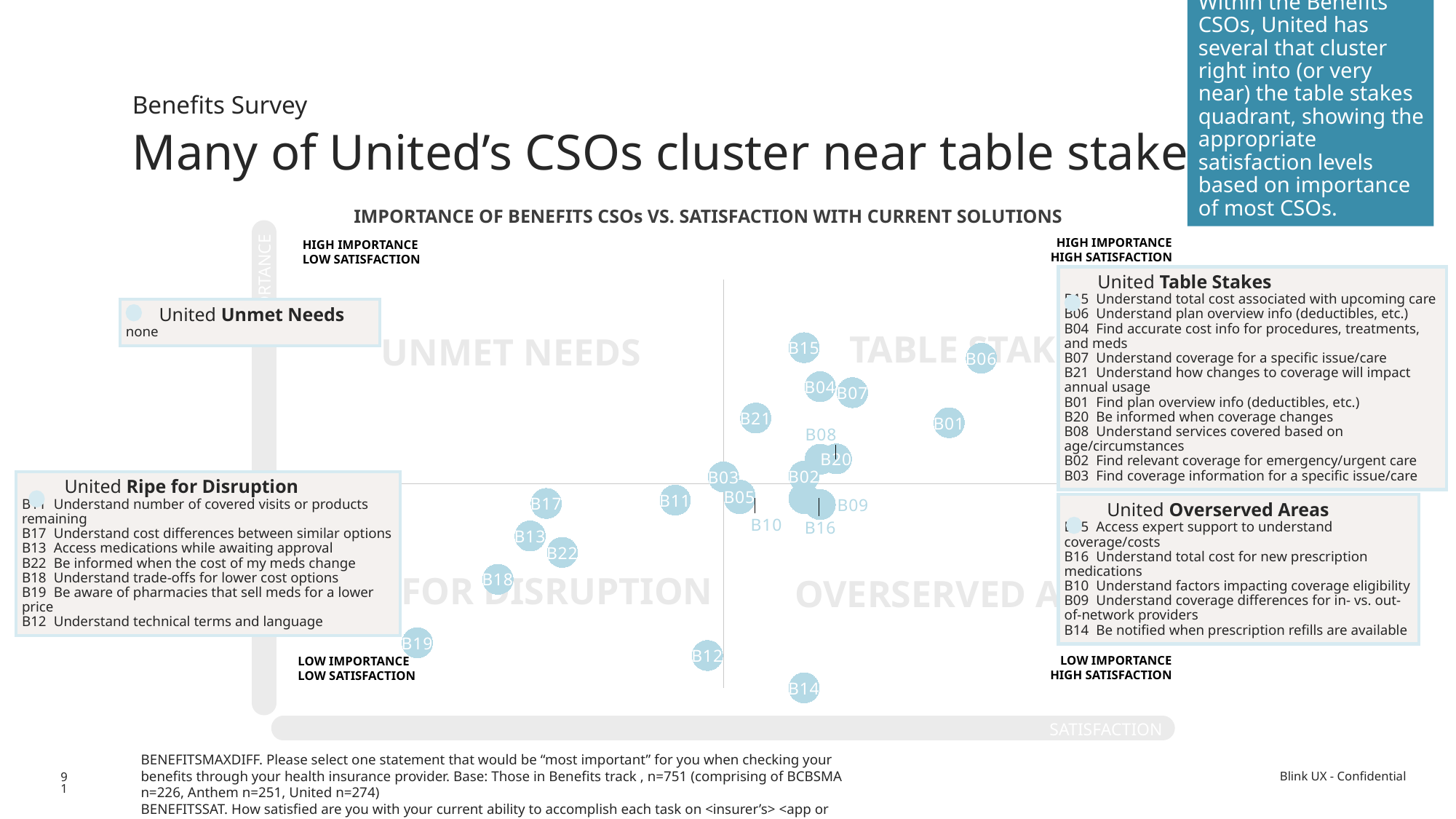
Which quadrant of the chart does B01 fall in? Table Stakes Which has higher importance, B19 or B14? B19 Which data point has the lowest satisfaction (is plotted furthest left)? B19 What kind of chart is shown on the slide? Scatter chart How many of United's CSOs are listed in the Unmet Needs quadrant? none How many labeled data points are plotted on the chart? 22 Which quadrant of the chart does B14 fall in? Overserved Areas Which quadrant of the chart does B19 fall in? Ripe for Disruption Which data point has the highest satisfaction (is plotted furthest right)? B06 What is the title of the chart? IMPORTANCE OF BENEFITS CSOs VS. SATISFACTION WITH CURRENT SOLUTIONS Which has higher satisfaction, B18 or B22? B22 Which data point has the lowest importance (is plotted lowest on the chart)? B14